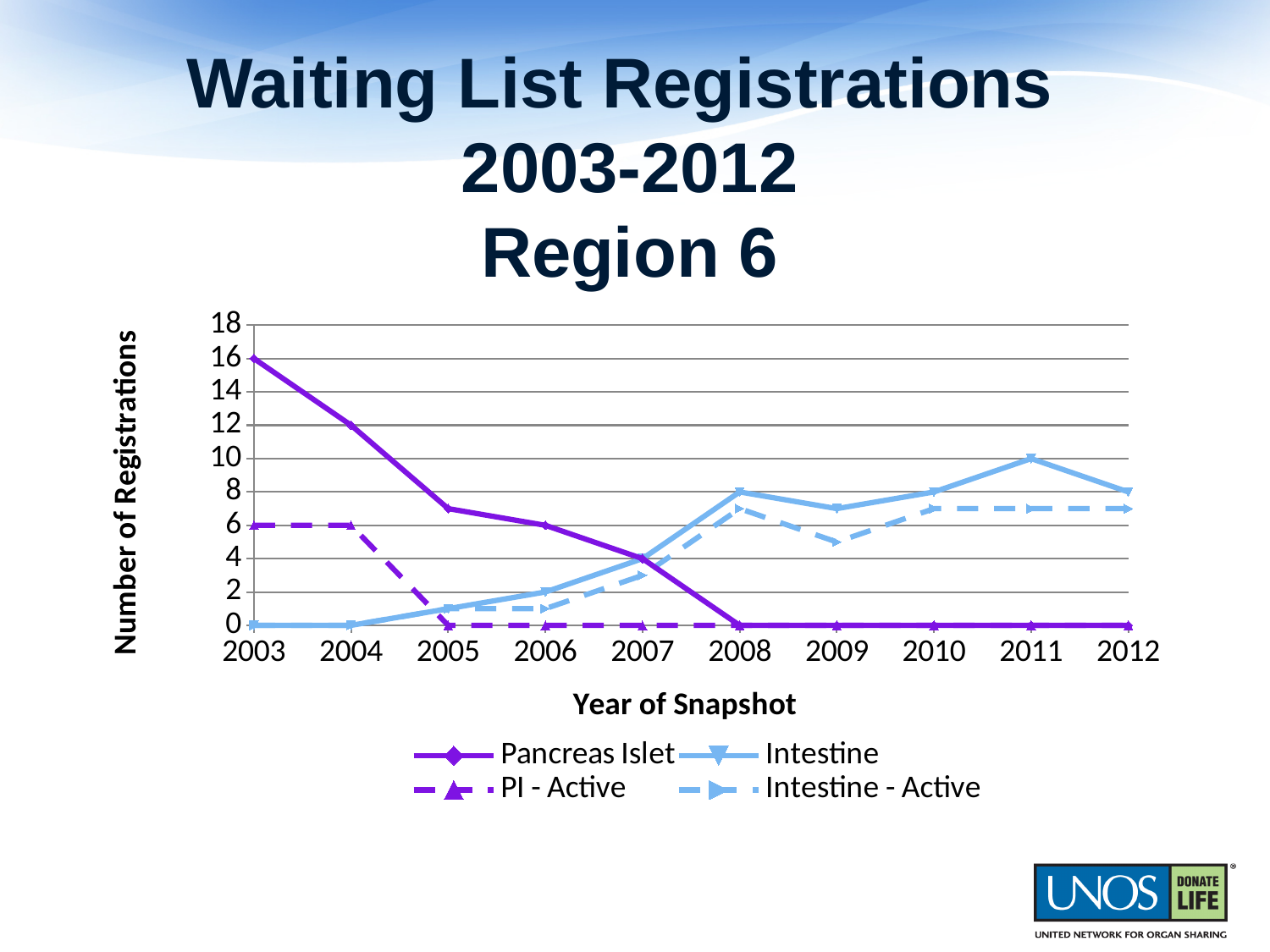
What is the number of PI - Active registrations in 2003? 6 What is the number of Pancreas Islet registrations in 2003? 16 Does the Pancreas Islet series rise or fall from 2003 to 2008? fall What is the number of Intestine registrations in 2008? 8 What is the difference between Pancreas Islet registrations in 2003 and 2004? 4 What type of chart is shown on the slide? line chart How many years are shown on the x axis? 10 In which year is the Intestine series at its highest? 2011 How many series does the legend list? 4 What is the number of Pancreas Islet registrations in 2004? 12 Is the value for Intestine in 2009 greater or less than 6? greater What is the number of Intestine registrations in 2011? 10